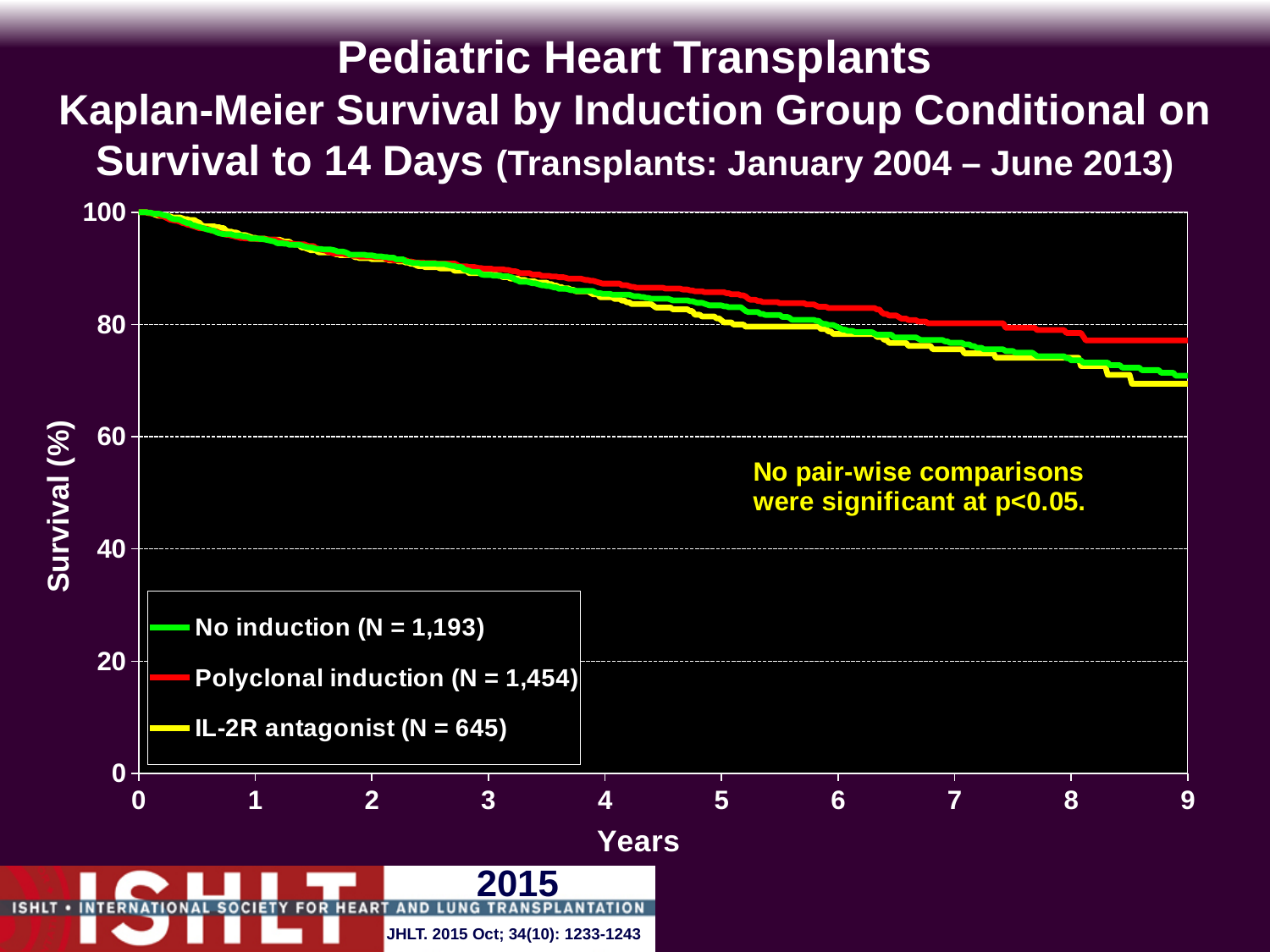
Is the survival for the Polyclonal induction group at 5 years greater or less than 80? greater What kind of chart is shown on the slide? Line chart What is the N for the IL-2R antagonist group shown in the legend? 645 Do the survival curves rise or fall as years increase? Fall What is the N for the Polyclonal induction group shown in the legend? 1,454 What is the N for the No induction group shown in the legend? 1,193 Which induction group has the highest survival at 9 years? Polyclonal induction Is the survival for the Polyclonal induction group at 9 years greater or less than 80? less What is the label on the x axis? Years What is the difference in N between the Polyclonal induction group and the No induction group? 261 Which induction group has the largest N in the legend? Polyclonal induction How many series does the legend list? 3